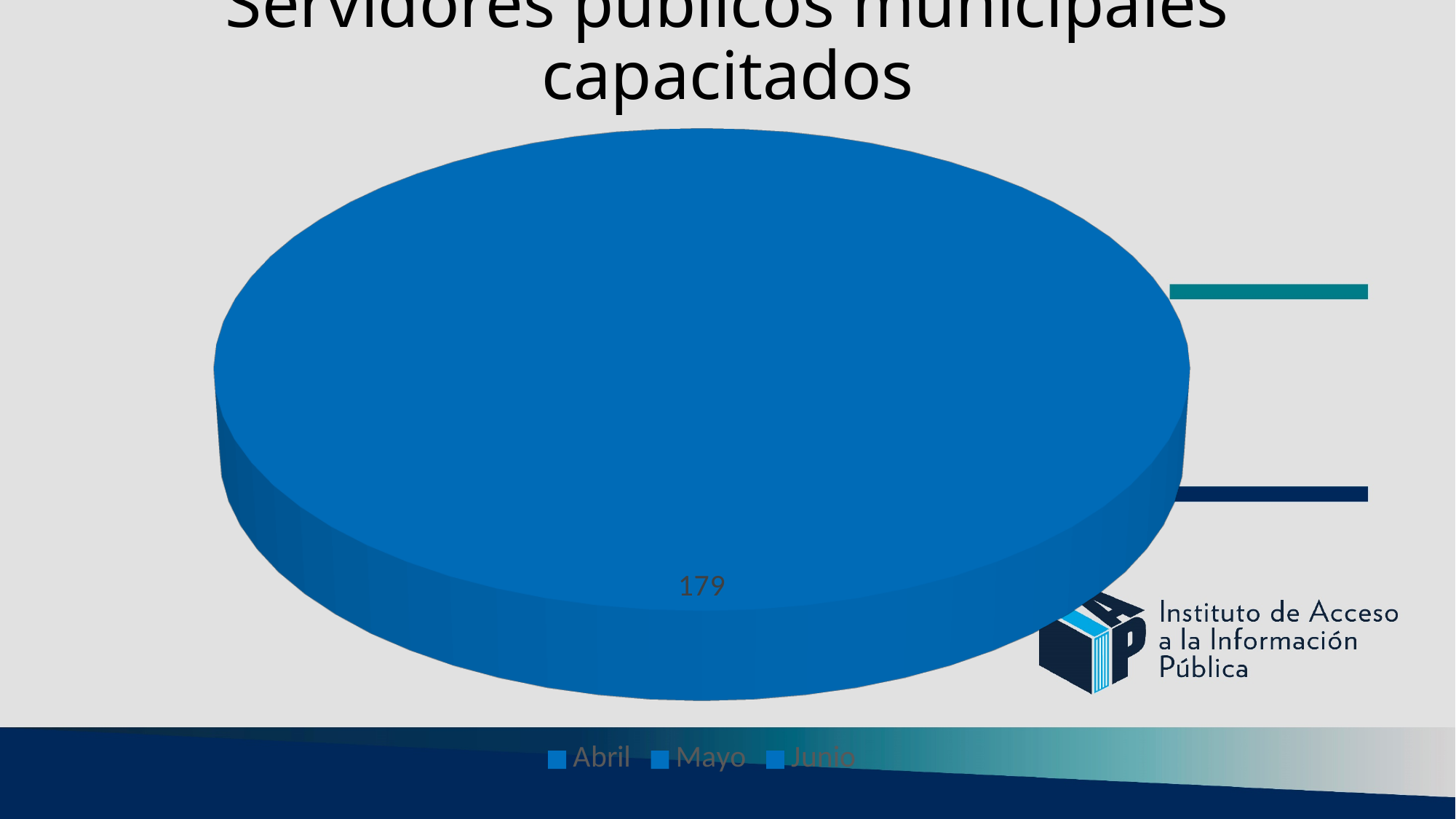
Is the value printed on the large slice greater or less than 100? greater How many entries does the chart's legend list? 3 What kind of chart is shown on the slide? pie chart What value is printed on the large blue slice of the pie? 179 Does the large blue slice take up nearly all of the pie or only a small part of it? nearly all of the pie Which months are listed in the chart's legend? Abril, Mayo, Junio What is the title of the chart? Servidores públicos municipales capacitados